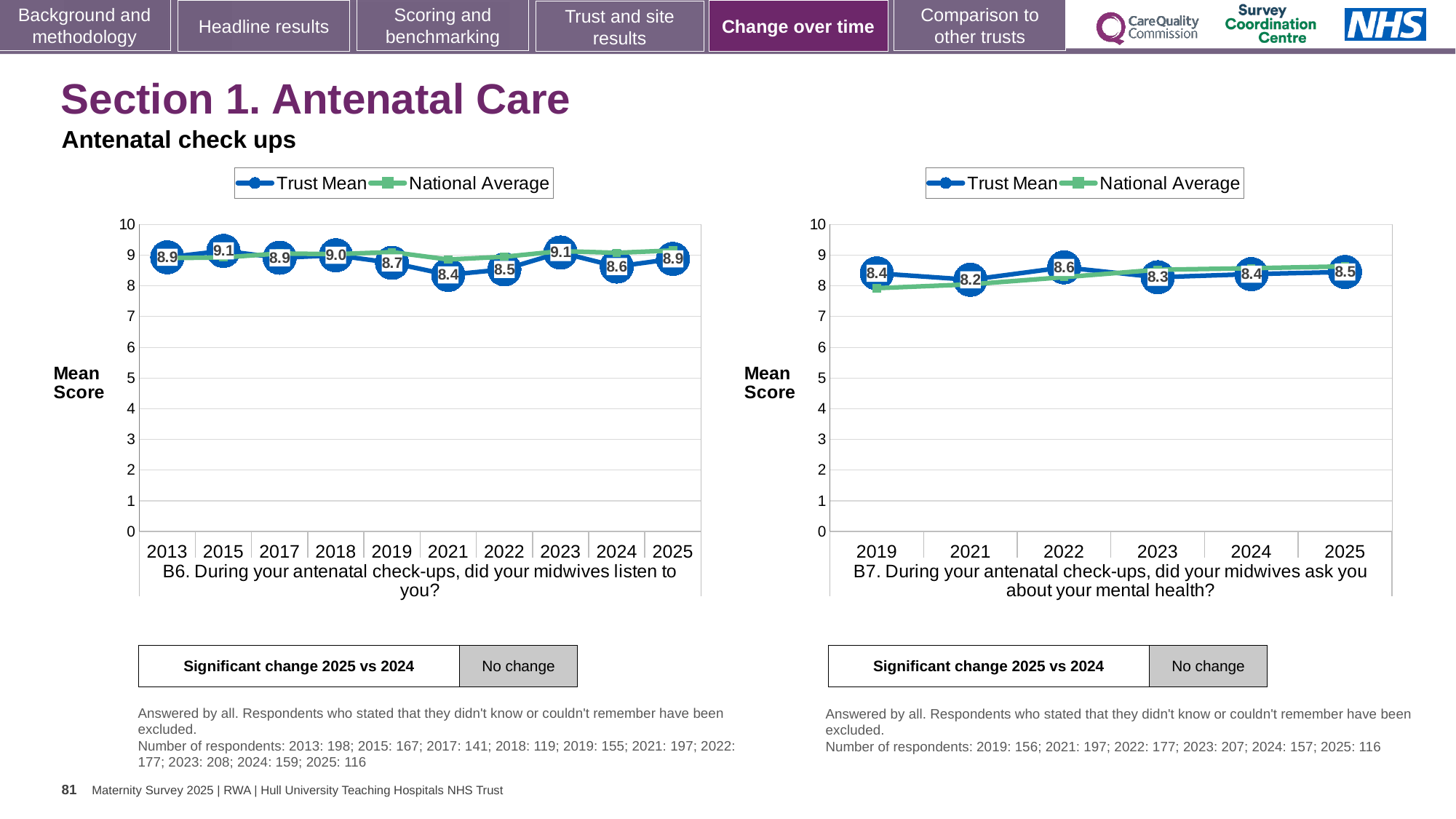
In the B6 chart (left), what is the Trust Mean for 2021? 8.4 What type of chart is used for the B6 chart (left)? Line chart In the B6 chart (left), is the National Average for 2013 greater or less than 8? greater In the B7 chart (right), which year has the lowest Trust Mean? 2021 How many series does the legend of the B6 chart (left) list? 2 How many years are plotted on the x axis of the B7 chart (right)? 6 In the B6 chart (left), is the Trust Mean higher in 2015 or in 2019? 2015 In the B6 chart (left), which year has the lowest Trust Mean? 2021 In the B6 chart (left), what is the difference between the Trust Mean in 2023 and in 2024? 0.5 In the B7 chart (right), which year has the highest Trust Mean? 2022 In the B7 chart (right), what is the difference between the Trust Mean in 2022 and in 2021? 0.4 In the B7 chart (right), what is the Trust Mean for 2022? 8.6